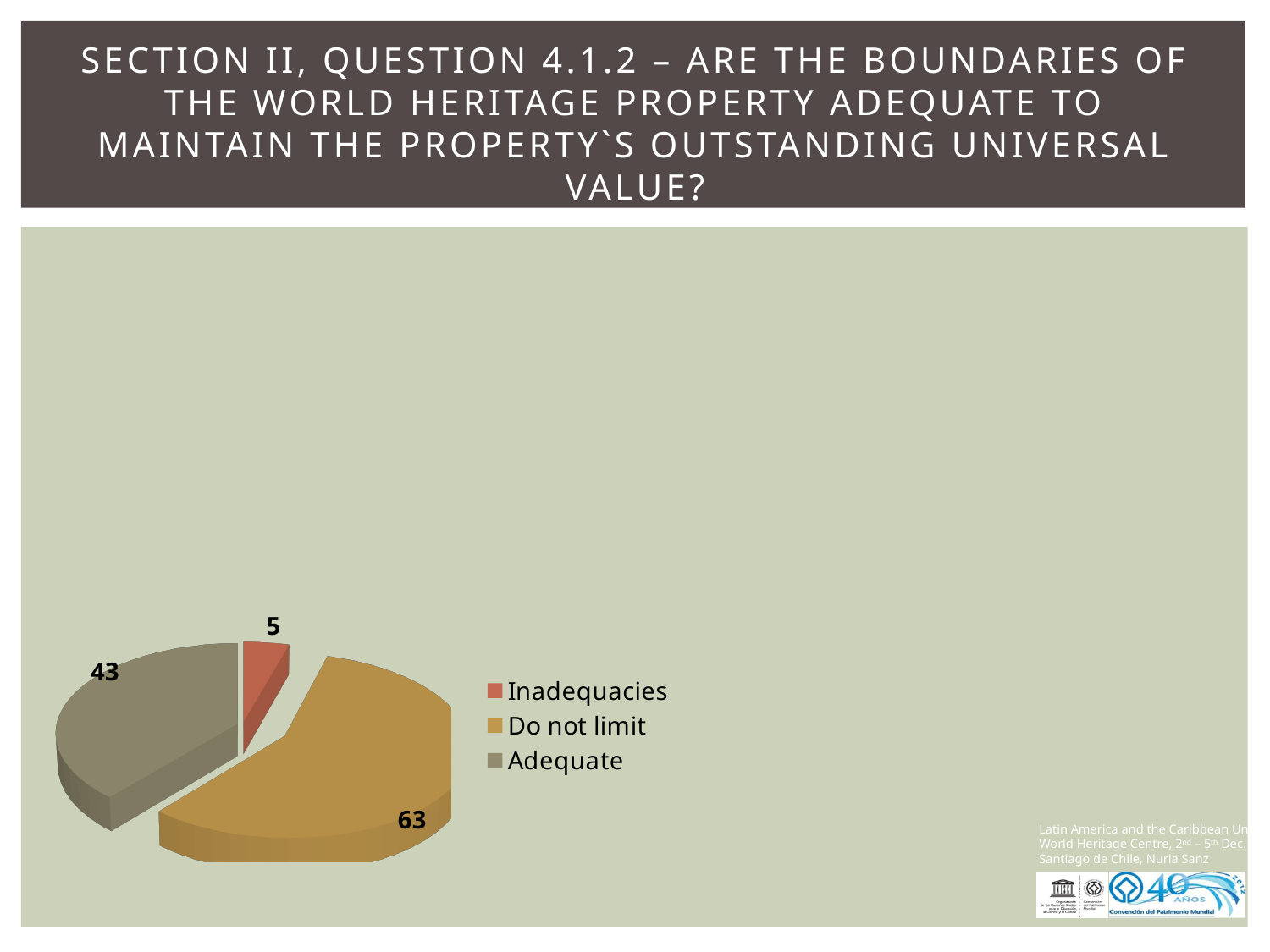
What is the difference between the "Do not limit" value and the "Adequate" value? 20 What kind of chart is shown on the slide? Pie chart What is the total of all three slice values in the pie chart? 111 Which category has the smallest slice in the pie chart? Inadequacies How many entries does the legend list? 3 What is the value for the "Do not limit" slice of the pie chart? 63 What is the value for the "Adequate" slice of the pie chart? 43 Which is larger, the "Adequate" slice or the "Inadequacies" slice? Adequate What is the difference between the "Adequate" value and the "Inadequacies" value? 38 How many slices does the pie chart have? 3 What is the value for the "Inadequacies" slice of the pie chart? 5 Which category has the largest slice in the pie chart? Do not limit